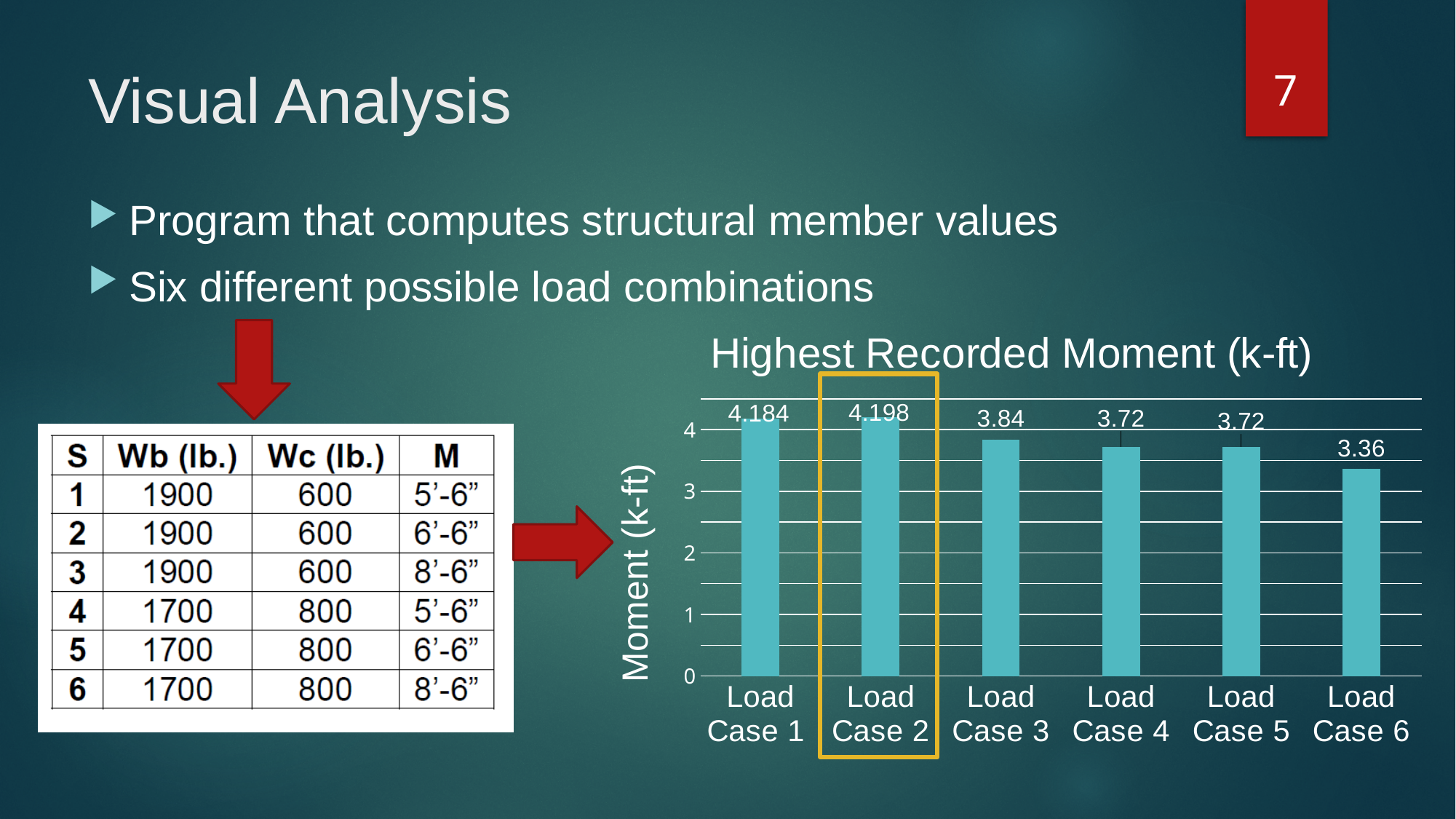
Which load case has the lowest recorded moment? Load Case 6 What kind of chart is shown on the slide? bar chart What is the difference between the values for Load Case 3 and Load Case 6? 0.48 What is the difference between the values for Load Case 2 and Load Case 1? 0.014 What is the title of the chart? Highest Recorded Moment (k-ft) What is the value for Load Case 1? 4.184 Is the value for Load Case 6 greater or less than 4? less What is the value for Load Case 6? 3.36 Which is larger, the value for Load Case 3 or Load Case 4? Load Case 3 What is the value for Load Case 3? 3.84 How many load cases are plotted in the chart? 6 Which load case has the highest recorded moment? Load Case 2